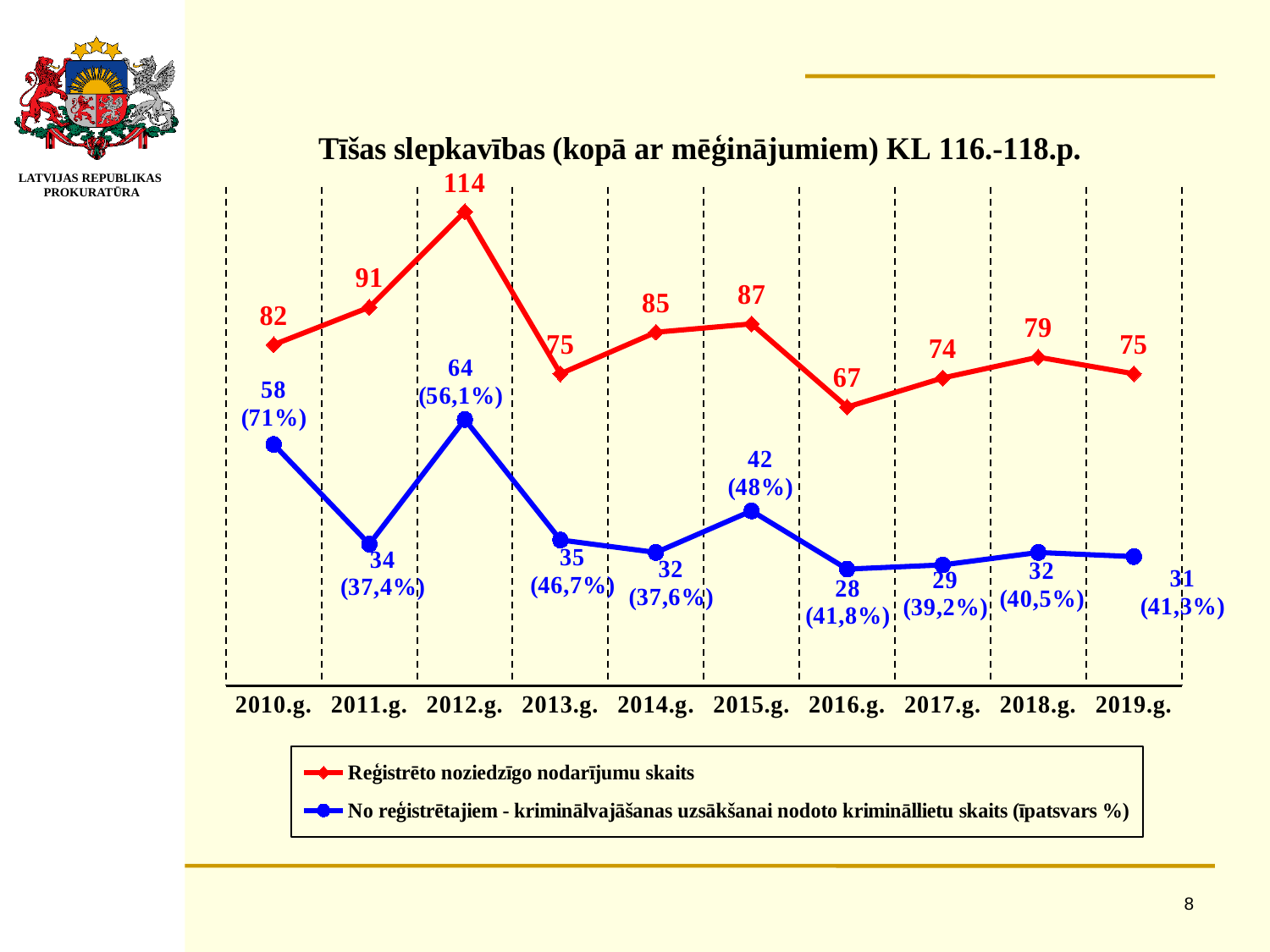
What is the number of cases handed over for criminal prosecution (blue series) in 2015.g.? 42 Which is larger: the red series value in 2011.g. or in 2015.g.? 2011.g. In which year is 'Reģistrēto noziedzīgo nodarījumu skaits' highest? 2012.g. What is the title of the chart? Tīšas slepkavības (kopā ar mēģinājumiem) KL 116.-118.p. How many years are shown on the x axis? 10 What percentage share is shown for the blue series in 2010.g.? 71% What is the value of 'Reģistrēto noziedzīgo nodarījumu skaits' in 2016.g.? 67 In which year is the blue series (cases handed over for prosecution) lowest? 2016.g. What is the difference between the red series value in 2012.g. and in 2013.g.? 39 How many series does the legend list? 2 What is the value of 'Reģistrēto noziedzīgo nodarījumu skaits' in 2012.g.? 114 What type of chart is shown on the slide? line chart